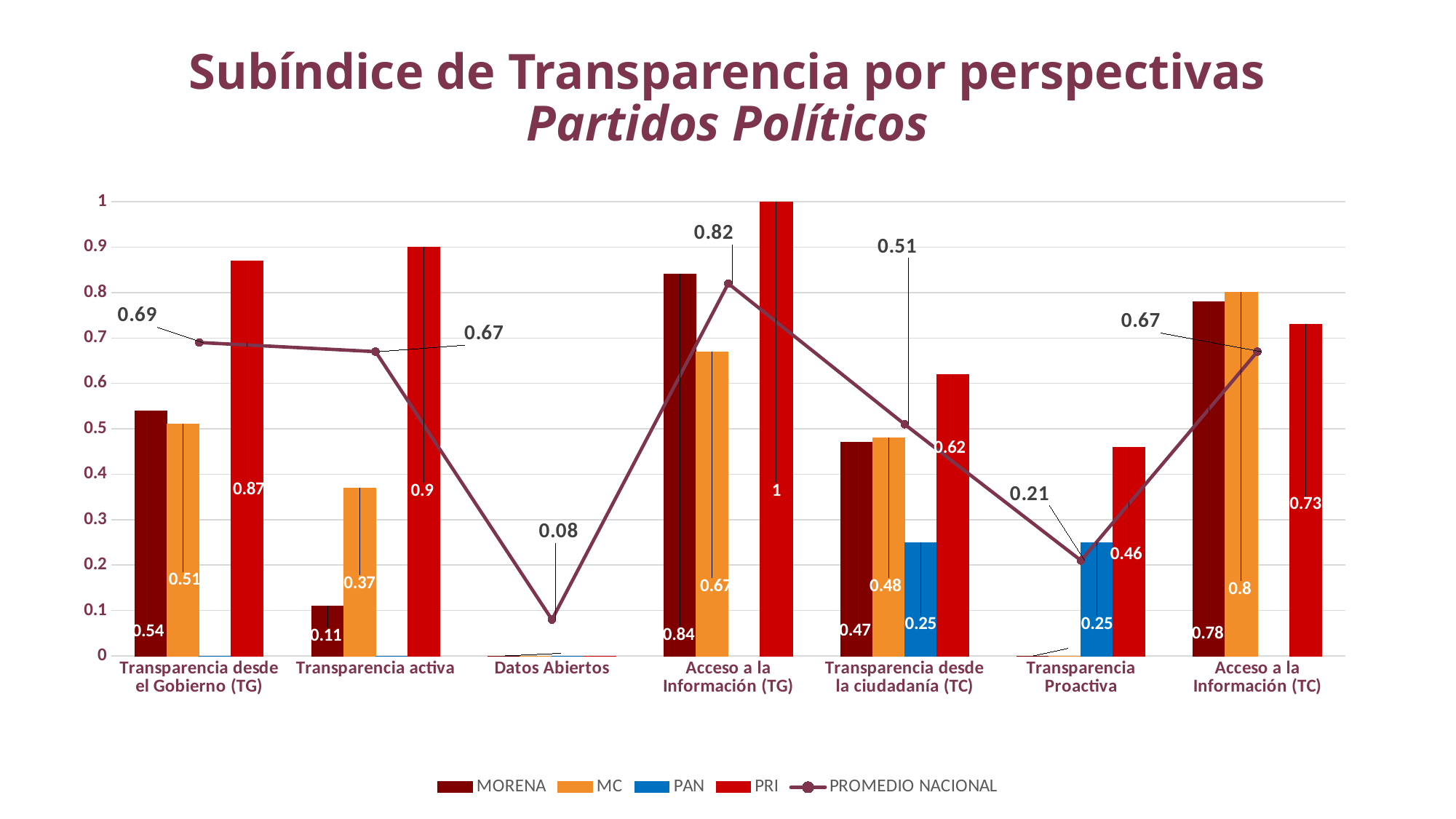
What is the PROMEDIO NACIONAL value for Datos Abiertos? 0.08 Which is larger for Transparencia desde la ciudadanía (TC): the MC value or the MORENA value? MC What is the PAN value for Transparencia Proactiva? 0.25 Is the PRI value for Transparencia Proactiva greater or less than 0.5? less Which category has the highest PRI value? Acceso a la Información (TG) What is the MORENA value for Transparencia activa? 0.11 How many series does the legend list? 5 What is the PRI value for Acceso a la Información (TG)? 1 What is the MC value for Acceso a la Información (TC)? 0.8 Which category has the lowest PROMEDIO NACIONAL value? Datos Abiertos How many categories are shown on the x axis? 7 What is the difference between the PRI value and the MORENA value for Transparencia desde el Gobierno (TG)? 0.33